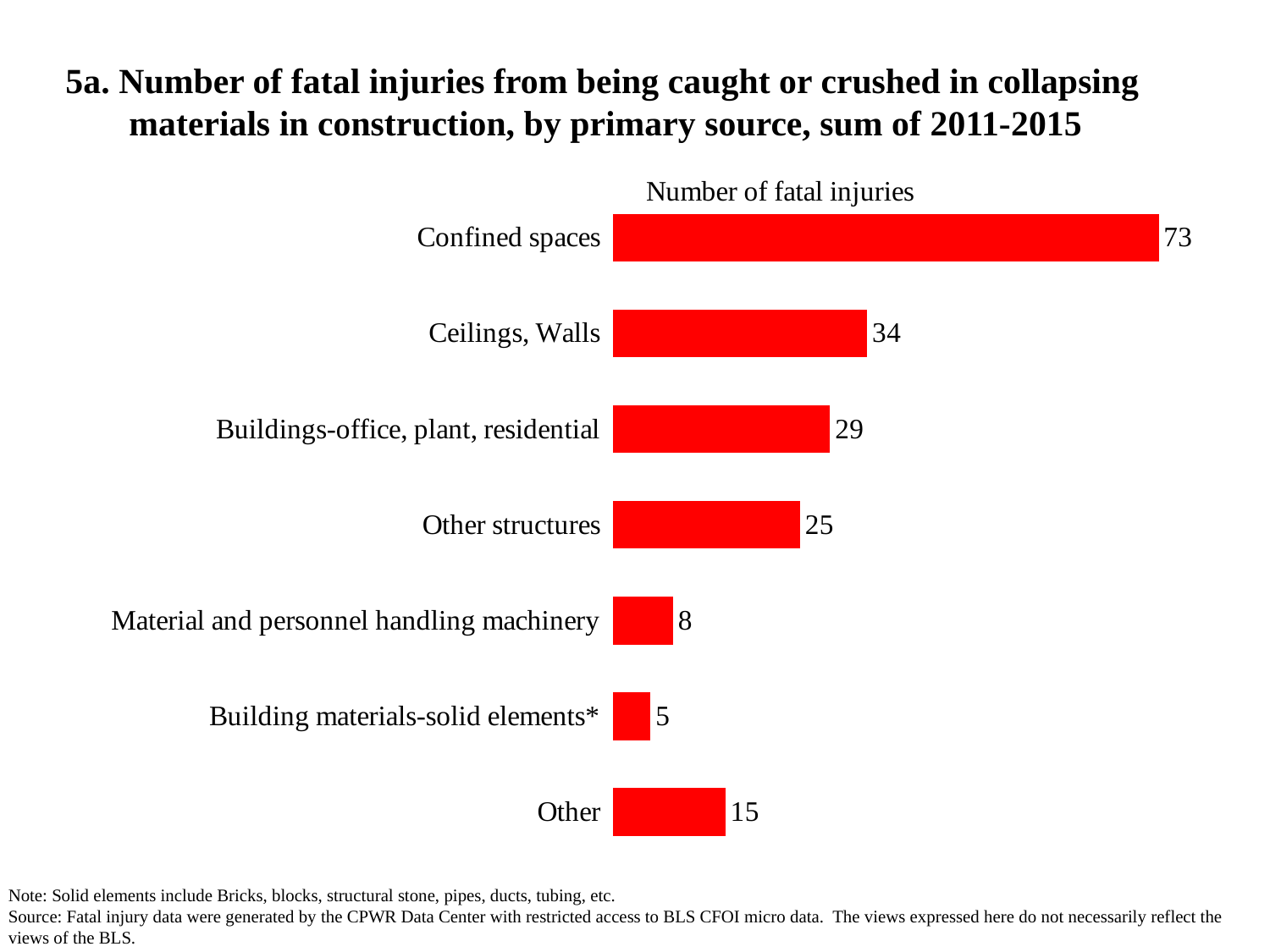
How many fatal injuries are shown for Confined spaces? 73 What is the number of fatal injuries for Ceilings, Walls? 34 How many primary source categories are shown in the chart? 7 What is the value for Other structures? 25 Which primary source has the lowest number of fatal injuries? Building materials-solid elements* What kind of chart is shown on the slide? Bar chart What is the difference between the values for Confined spaces and Ceilings, Walls? 39 Which has a larger value, Buildings-office, plant, residential or Other structures? Buildings-office, plant, residential What is the difference between the values for Other and Material and personnel handling machinery? 7 Which primary source has the highest number of fatal injuries? Confined spaces What is the axis title shown above the bars? Number of fatal injuries What is the value for Building materials-solid elements*? 5